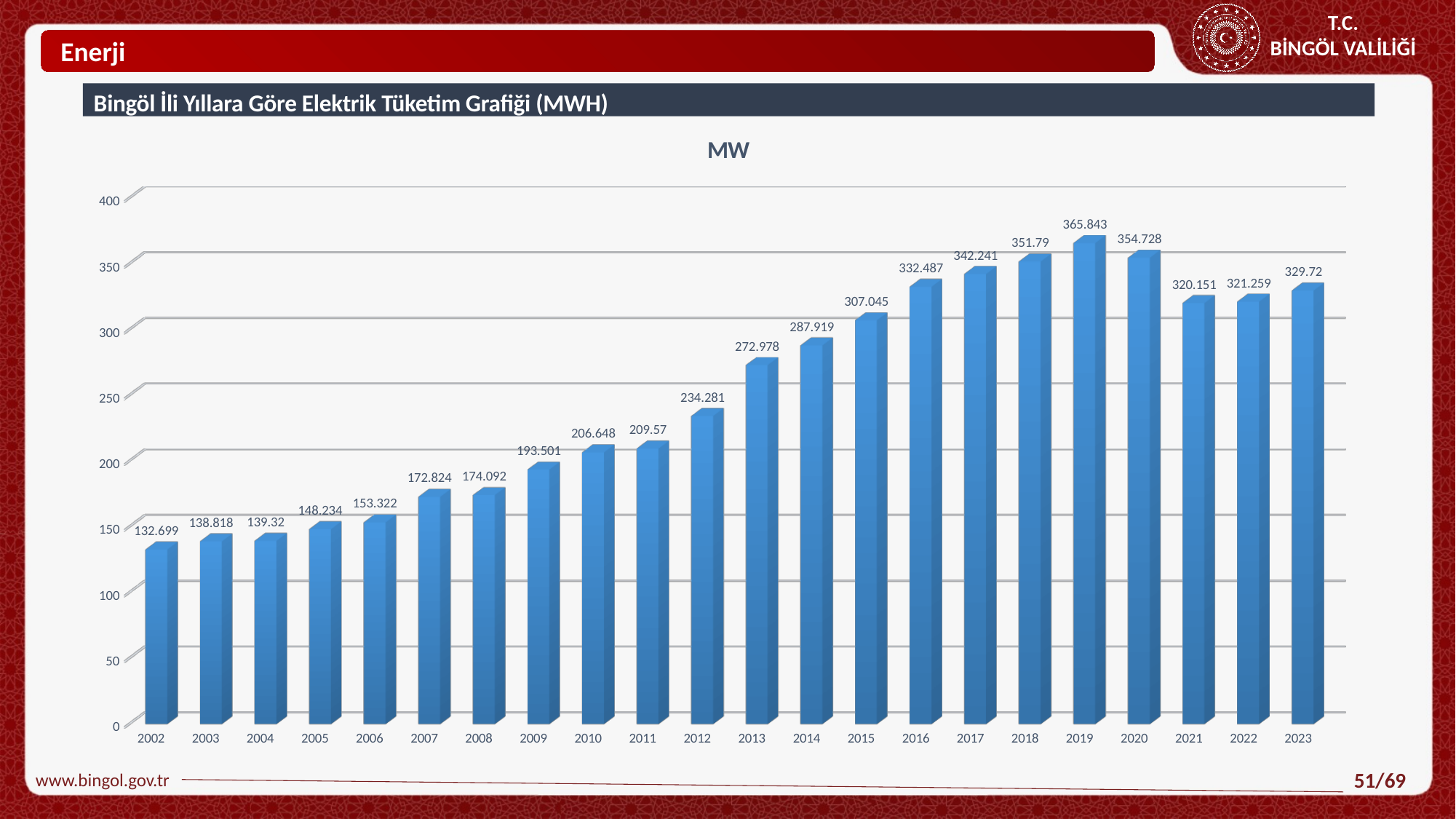
Which is larger, the value for 2018 or the value for 2021? 2018 How many years are shown on the x axis? 22 What is the value for 2019? 365.843 Which year has the highest value? 2019 What is the value for 2002? 132.699 What kind of chart is shown on the slide? bar chart What is the difference between the values for 2023 and 2022? 8.461 Which year has the lowest value? 2002 What is the difference between the values for 2019 and 2020? 11.115 What is the value for 2023? 329.72 What is the title shown above the chart? MW Is the value for 2012 greater or less than 250? less